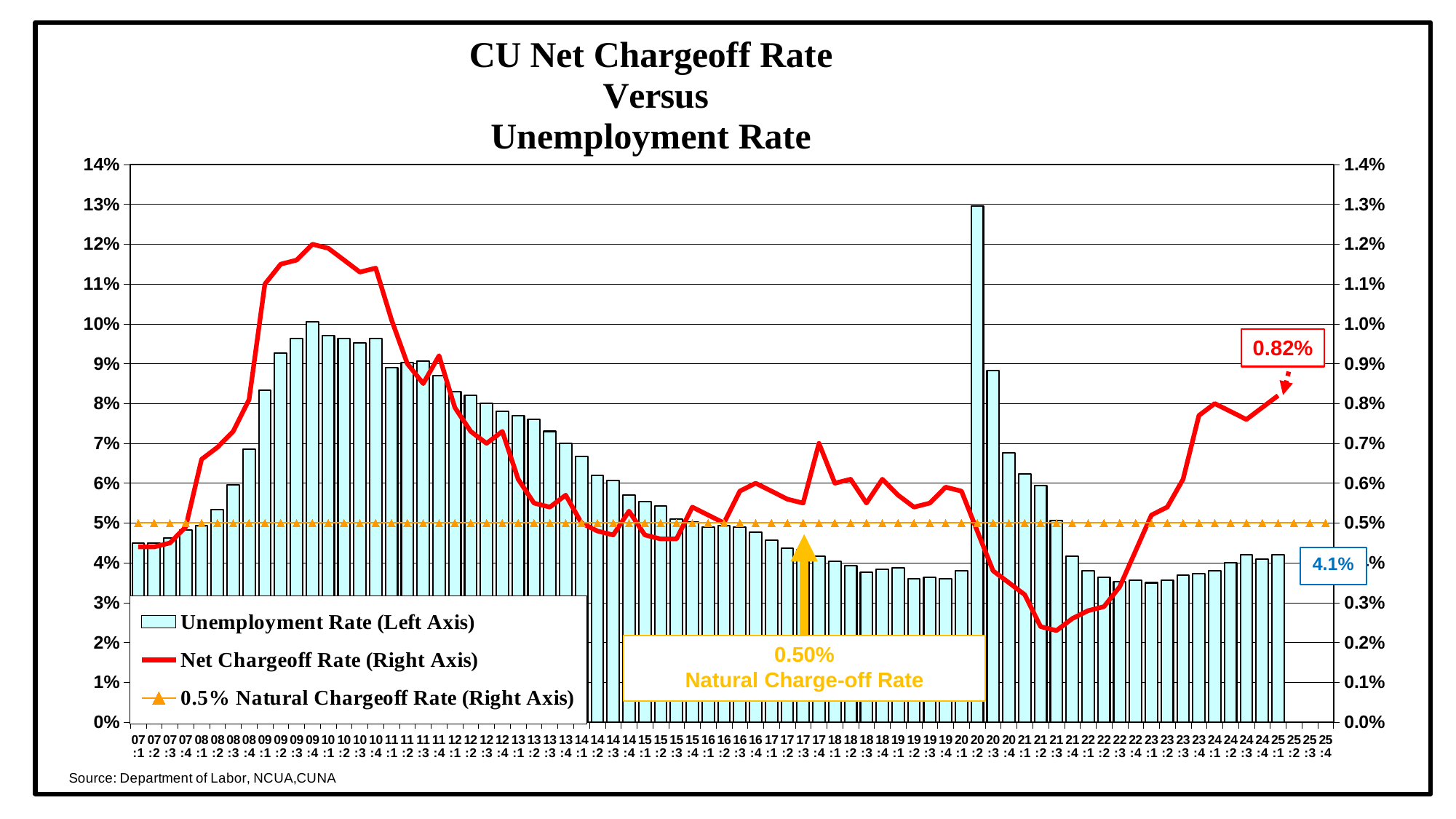
What kind of chart is shown on the slide? A combination bar and line chart Is the Unemployment Rate in 20:2 greater or less than 12%? greater Is the Net Chargeoff Rate in 21:3 greater or less than 0.3%? less Is the Net Chargeoff Rate at 25:1 above or below the 0.5% Natural Chargeoff Rate? above In which quarter is the Unemployment Rate bar the highest? 20:2 By how much does the 25:1 Net Chargeoff Rate (0.82%) exceed the 0.50% Natural Charge-off Rate? 0.32% What is the labeled Net Chargeoff Rate at the most recent point (25:1)? 0.82% Does the Net Chargeoff Rate rise or fall from 21:3 to 25:1? rise What is the labeled Unemployment Rate at the most recent point (25:1)? 4.1% Is the Unemployment Rate in 07:1 greater or less than 5%? less How many series does the legend list? 3 What value is given for the Natural Charge-off Rate? 0.50%